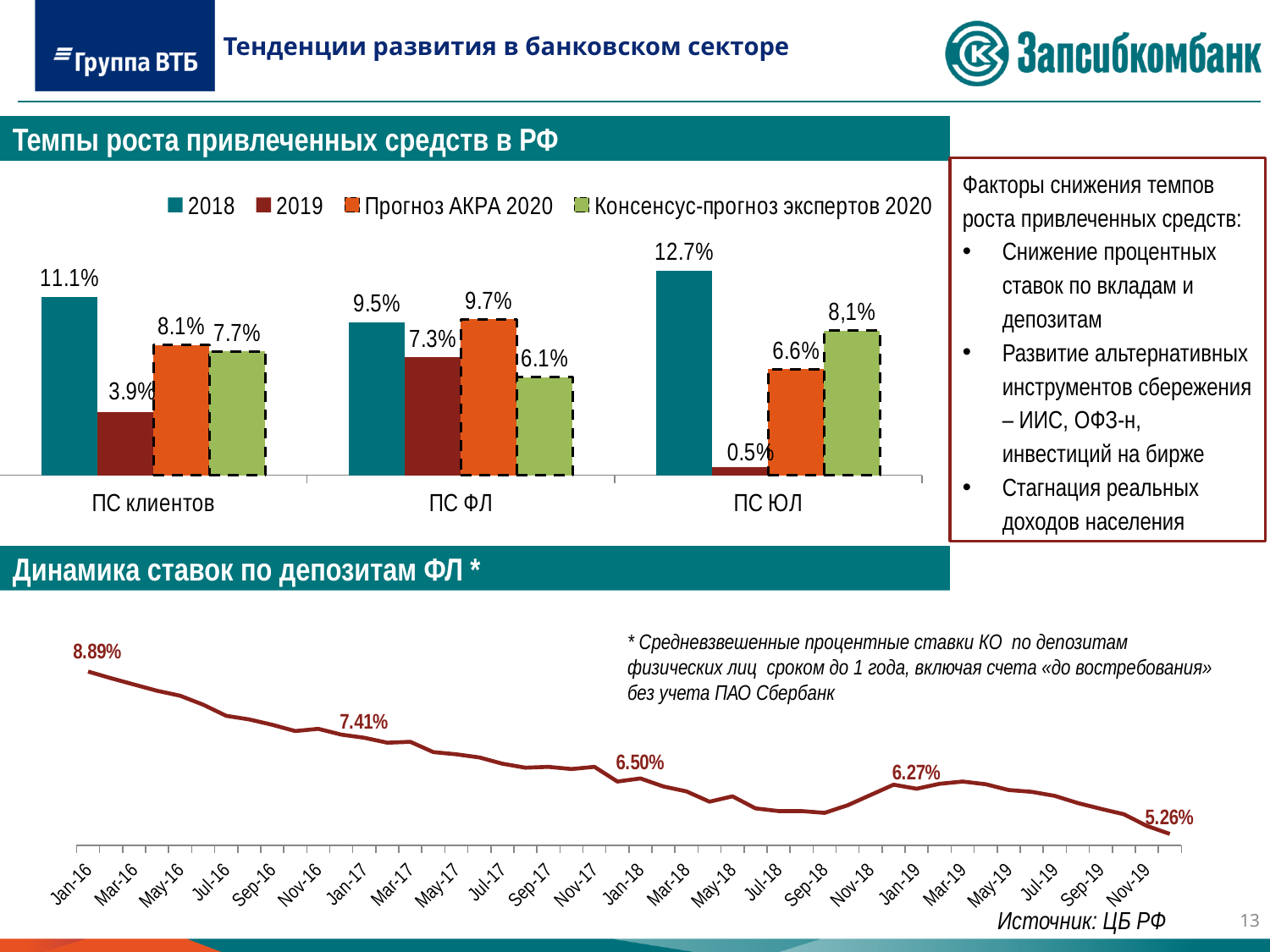
How many series does the legend of the chart 'Темпы роста привлеченных средств в РФ' list? 4 In the chart 'Темпы роста привлеченных средств в РФ', what is the 2019 value for ПС клиентов? 3.9% In the chart 'Темпы роста привлеченных средств в РФ', what is the Прогноз АКРА 2020 value for ПС ФЛ? 9.7% In the chart 'Темпы роста привлеченных средств в РФ', what is the difference between the 2018 and 2019 values for ПС ЮЛ? 12.2% How many categories are shown on the x axis of the chart 'Темпы роста привлеченных средств в РФ'? 3 In the chart 'Темпы роста привлеченных средств в РФ', which category has the highest 2018 value? ПС ЮЛ In the chart 'Темпы роста привлеченных средств в РФ', what is the 2018 value for ПС ЮЛ? 12.7% In the chart 'Темпы роста привлеченных средств в РФ', which is larger for ПС ФЛ: the Прогноз АКРА 2020 value or the Консенсус-прогноз экспертов 2020 value? Прогноз АКРА 2020 In the chart 'Динамика ставок по депозитам ФЛ *', do the values generally rise or fall from Jan-16 to Nov-19? Fall What kind of chart is 'Динамика ставок по депозитам ФЛ *'? Line chart In the chart 'Темпы роста привлеченных средств в РФ', which category has the lowest 2019 value? ПС ЮЛ In the chart 'Динамика ставок по депозитам ФЛ *', what is the value labelled at the start of the line (Jan-16)? 8.89%